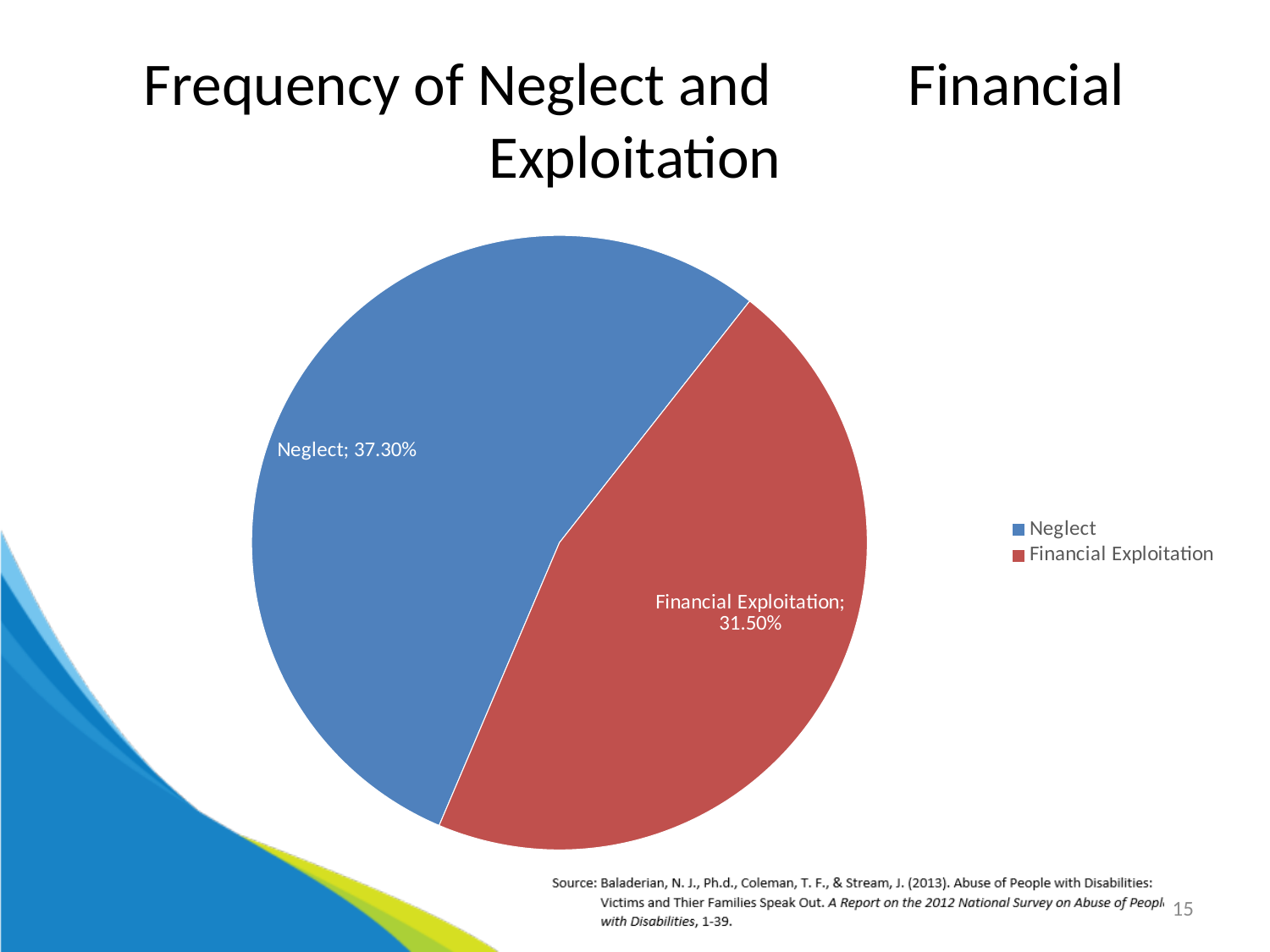
What is the difference between the values for Neglect and Financial Exploitation? 5.80% How many slices does the pie chart have? 2 How many entries does the legend list? 2 What is the value shown for Neglect? 37.30% What type of chart is shown on the slide? Pie chart What colour is the Financial Exploitation slice? Red Which category has the highest value? Neglect Which is larger, the value for Neglect or the value for Financial Exploitation? Neglect What is the value shown for Financial Exploitation? 31.50% Which category has the lowest value? Financial Exploitation What is the title of the slide containing the chart? Frequency of Neglect and Financial Exploitation